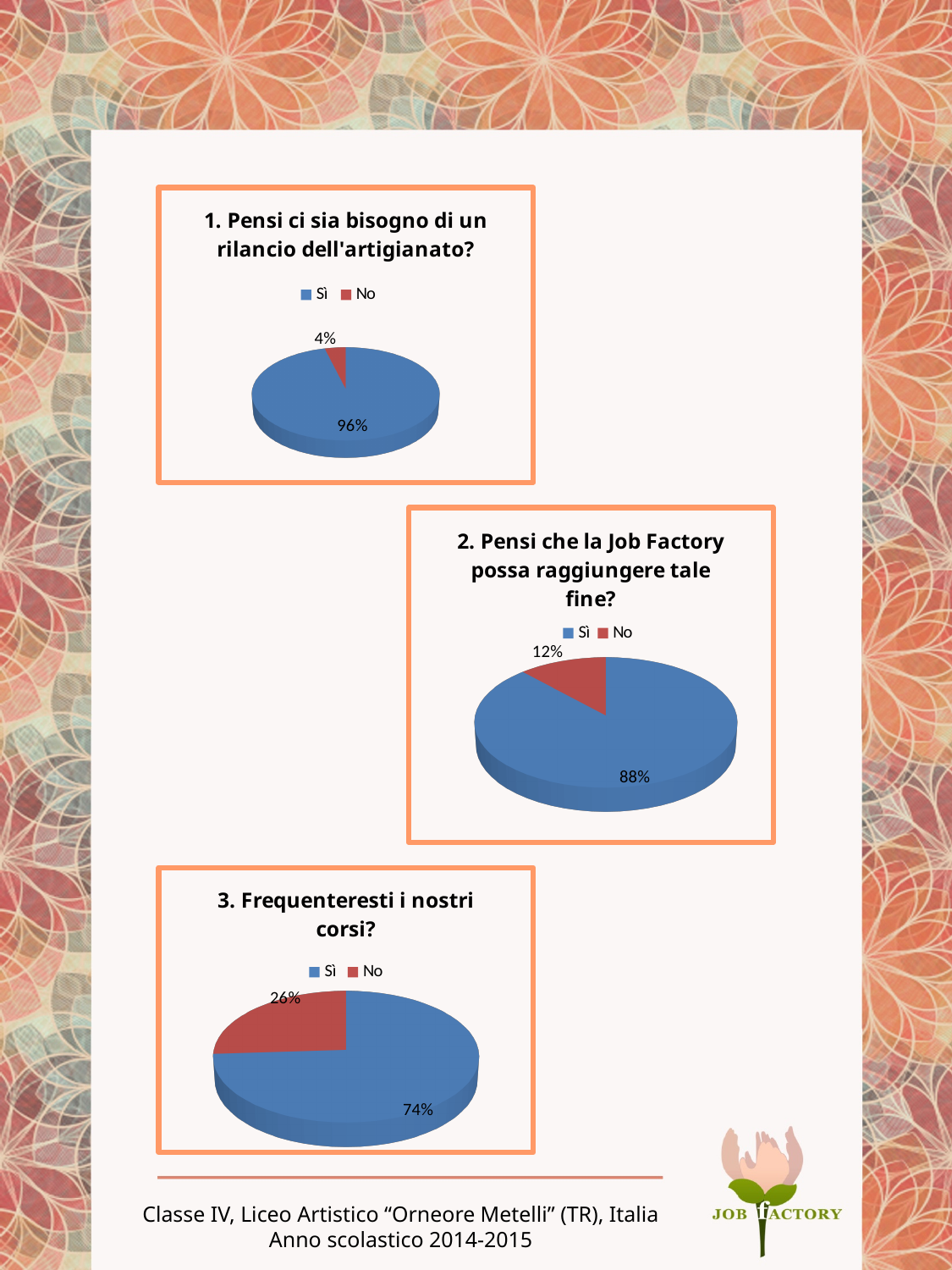
In the chart titled "1. Pensi ci sia bisogno di un rilancio dell'artigianato?", what percentage answered Sì? 96% What kind of chart is used in the chart titled "3. Frequenteresti i nostri corsi?"? Pie chart In the chart titled "3. Frequenteresti i nostri corsi?", what percentage answered No? 26% In the chart titled "2. Pensi che la Job Factory possa raggiungere tale fine?", what percentage answered No? 12% In the chart titled "1. Pensi ci sia bisogno di un rilancio dell'artigianato?", what percentage answered No? 4% In the chart titled "2. Pensi che la Job Factory possa raggiungere tale fine?", which answer has the smallest share? No In the chart titled "1. Pensi ci sia bisogno di un rilancio dell'artigianato?", what is the difference between the Sì and No percentages? 92% In the chart titled "3. Frequenteresti i nostri corsi?", which answer has the largest share? Sì In the chart titled "3. Frequenteresti i nostri corsi?", what percentage answered Sì? 74% In the chart titled "1. Pensi ci sia bisogno di un rilancio dell'artigianato?", what colour is the Sì slice? Blue In the chart titled "2. Pensi che la Job Factory possa raggiungere tale fine?", what percentage answered Sì? 88% How many entries does the legend list in the chart titled "2. Pensi che la Job Factory possa raggiungere tale fine?"? 2